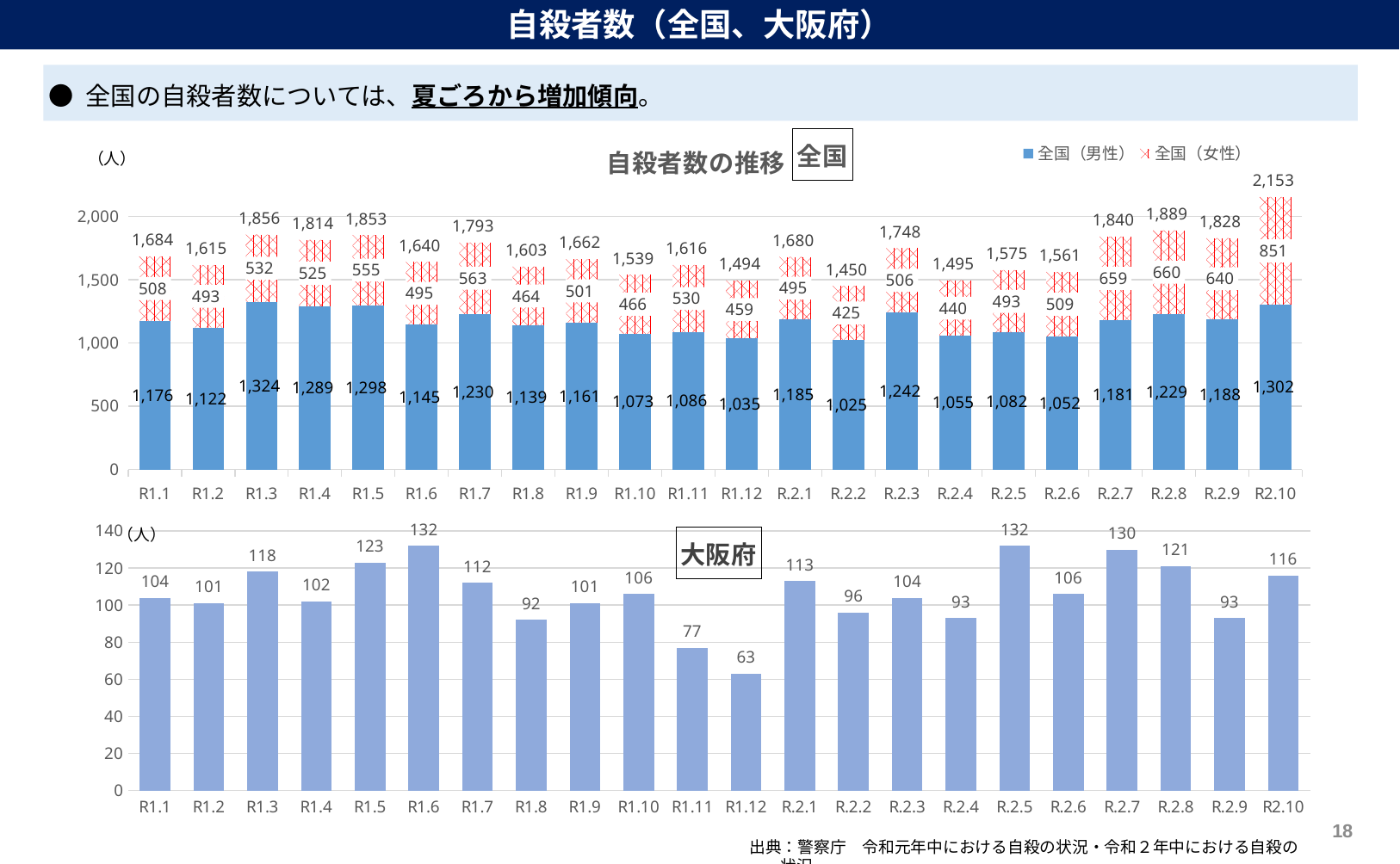
In the bottom chart (大阪府), how many months are plotted? 22 In the top chart (自殺者数の推移 全国), which is larger, the female value in R1.5 or in R1.8? R1.5 In the top chart (自殺者数の推移 全国), which month has the lowest total? R.2.2 In the bottom chart (大阪府), what is the difference between R2.5 and R2.6? 26 In the bottom chart (大阪府), what is the value for R1.11? 77 In the bottom chart (大阪府), which month has the lowest value? R1.12 In the top chart (自殺者数の推移 全国), how many series does the legend list? 2 In the top chart (自殺者数の推移 全国), what is the value for 全国（女性） in R2.2? 425 In the top chart (自殺者数の推移 全国), what is the difference between the male and female values in R2.10? 451 In the top chart (自殺者数の推移 全国), what is the value for 全国（男性） in R1.3? 1,324 In the top chart (自殺者数の推移 全国), what is the total number of suicides for R2.10? 2,153 What type of chart is the bottom chart (大阪府)? Bar chart